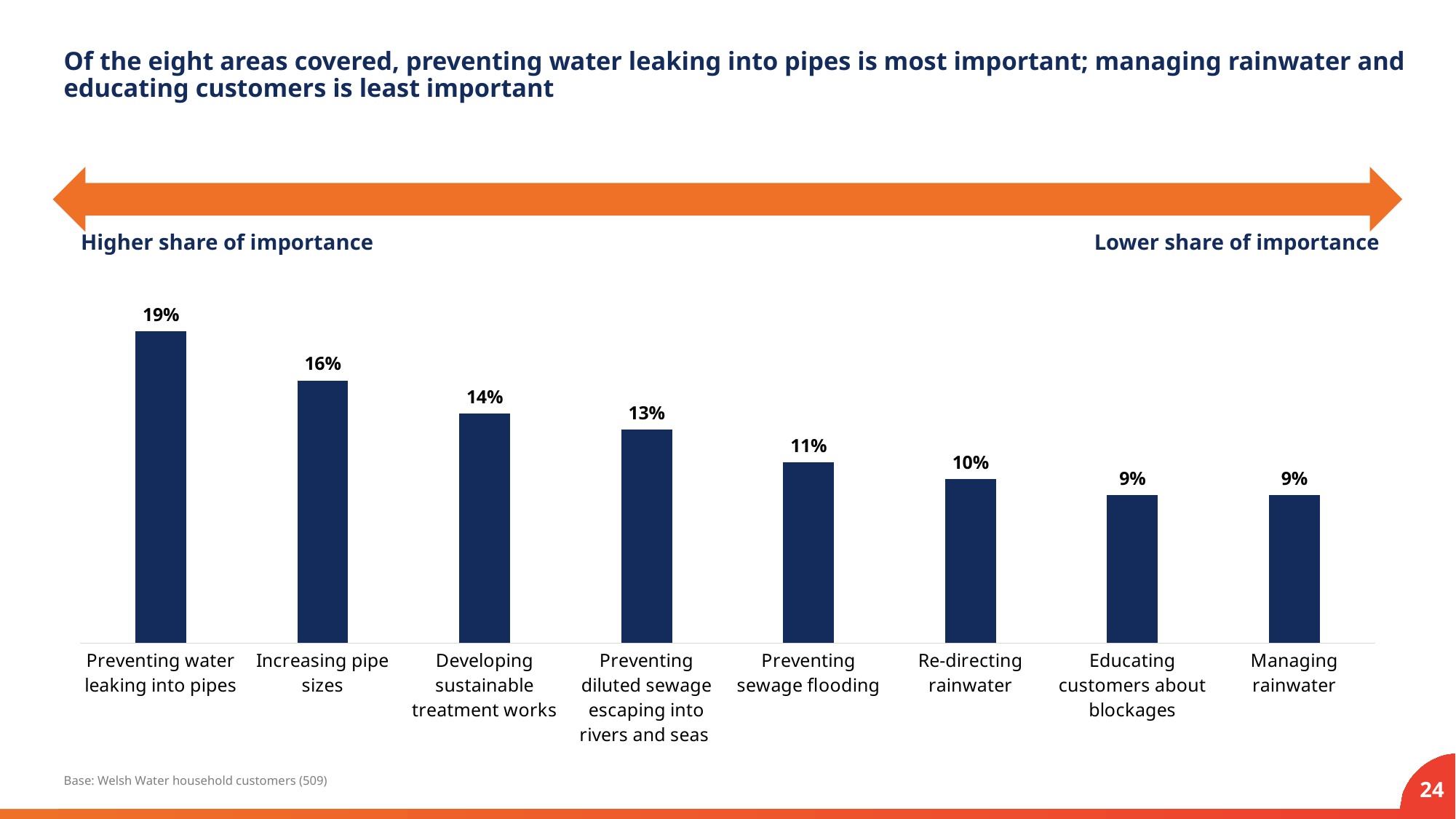
What is the value for Re-directing rainwater? 10% Which is larger, the value for Developing sustainable treatment works or the value for Preventing sewage flooding? Developing sustainable treatment works What is the value for Increasing pipe sizes? 16% How many categories are shown in the chart? 8 What is the difference between the values for Preventing sewage flooding and Managing rainwater? 2% What is the value for Developing sustainable treatment works? 14% What is the difference between the values for Preventing water leaking into pipes and Increasing pipe sizes? 3% What is the value for Preventing diluted sewage escaping into rivers and seas? 13% Which category has the highest value? Preventing water leaking into pipes What is the value for Preventing water leaking into pipes? 19% Do the values rise or fall from left to right along the x axis? Fall What kind of chart is shown on the slide? Bar chart